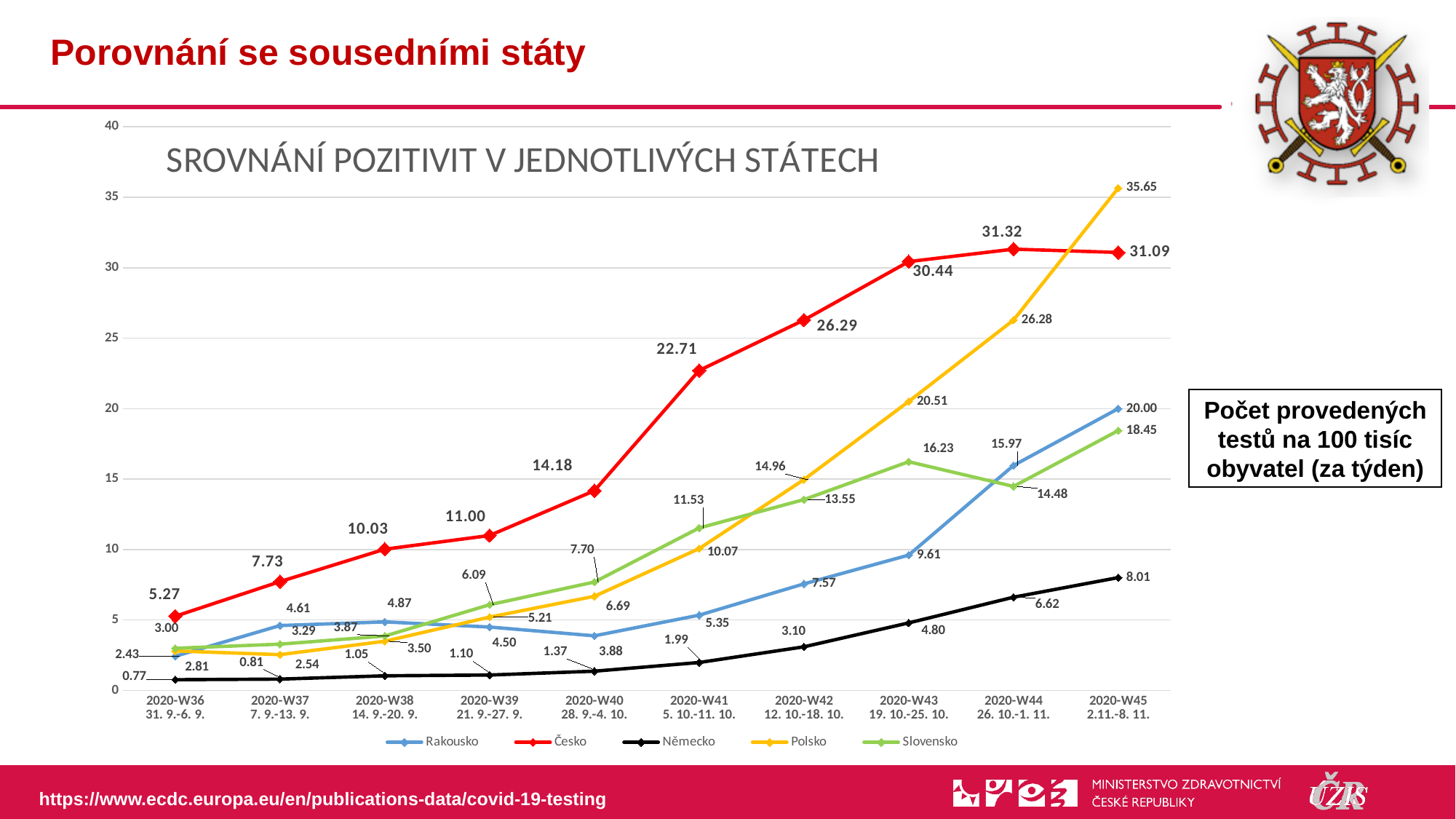
What is the value for Německo in week 2020-W45? 8.01 In week 2020-W43, which is larger: the value for Česko or the value for Polsko? Česko Which country has the lowest value in week 2020-W45? Německo What kind of chart is shown on the slide? line chart What is the value for Polsko in week 2020-W45? 35.65 Does the value for Česko generally rise or fall from 2020-W36 to 2020-W44? rise How many weeks are plotted along the x axis? 10 How many series does the legend list? 5 What is the value for Česko in week 2020-W44? 31.32 What is the value for Česko in week 2020-W36? 5.27 Which country has the highest value in week 2020-W45? Polsko What is the difference between the Česko values in 2020-W44 and 2020-W45? 0.23